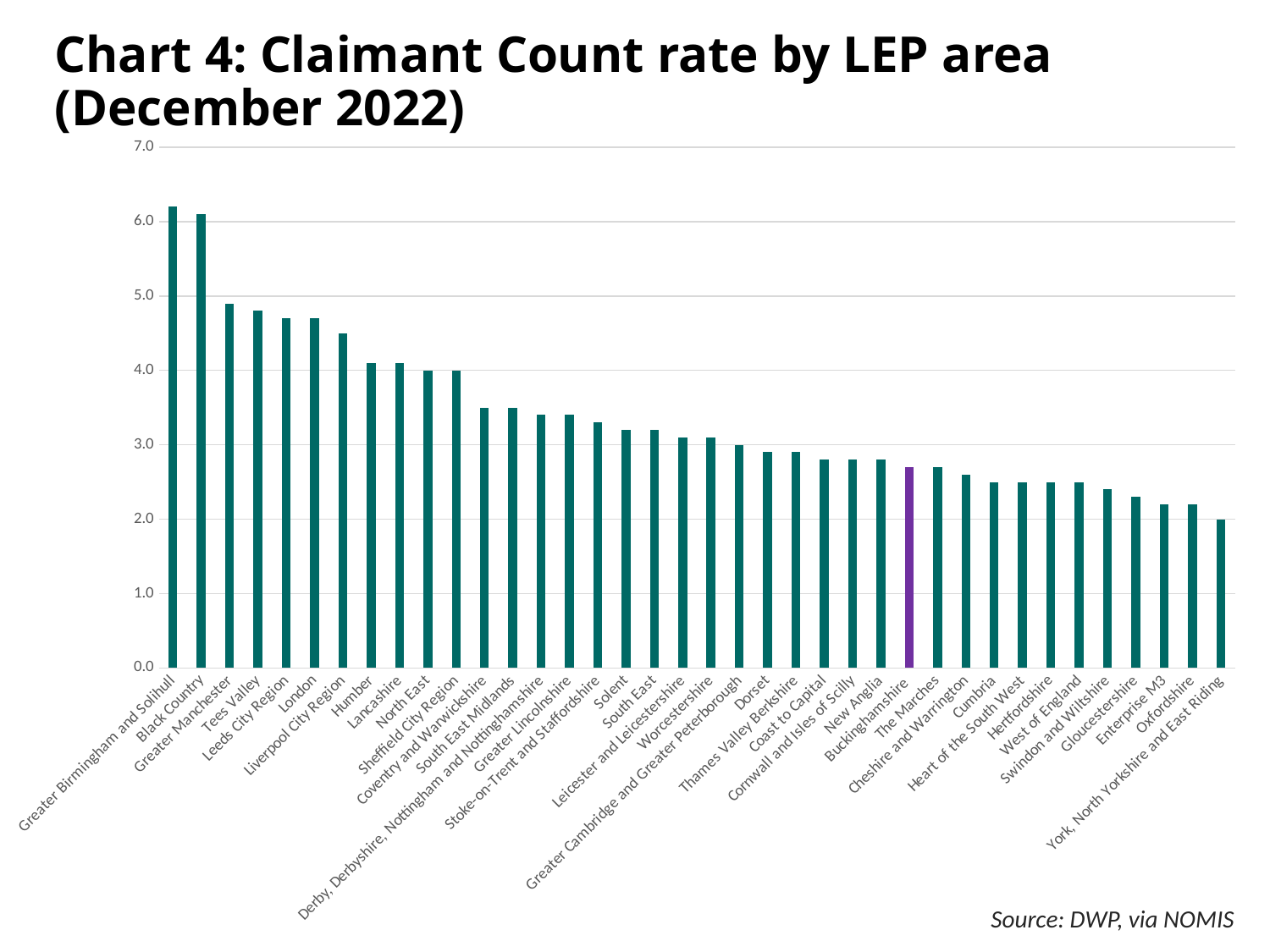
Is the value for Tees Valley greater or less than 5.0? less Is the value for Greater Birmingham and Solihull greater or less than 5.0? greater Is the value for London greater or less than 4.0? greater Do the values rise or fall moving from left to right along the x axis? Fall What kind of chart is shown on the slide? Bar chart Which has the higher Claimant Count rate, Dorset or Oxfordshire? Dorset How many LEP areas are plotted in the chart? 38 Which LEP area's bar is shown in a different colour (purple) from the others? Buckinghamshire Which has the higher Claimant Count rate, London or Lancashire? London Which LEP area has the highest Claimant Count rate? Greater Birmingham and Solihull Which LEP area has the lowest Claimant Count rate? York, North Yorkshire and East Riding